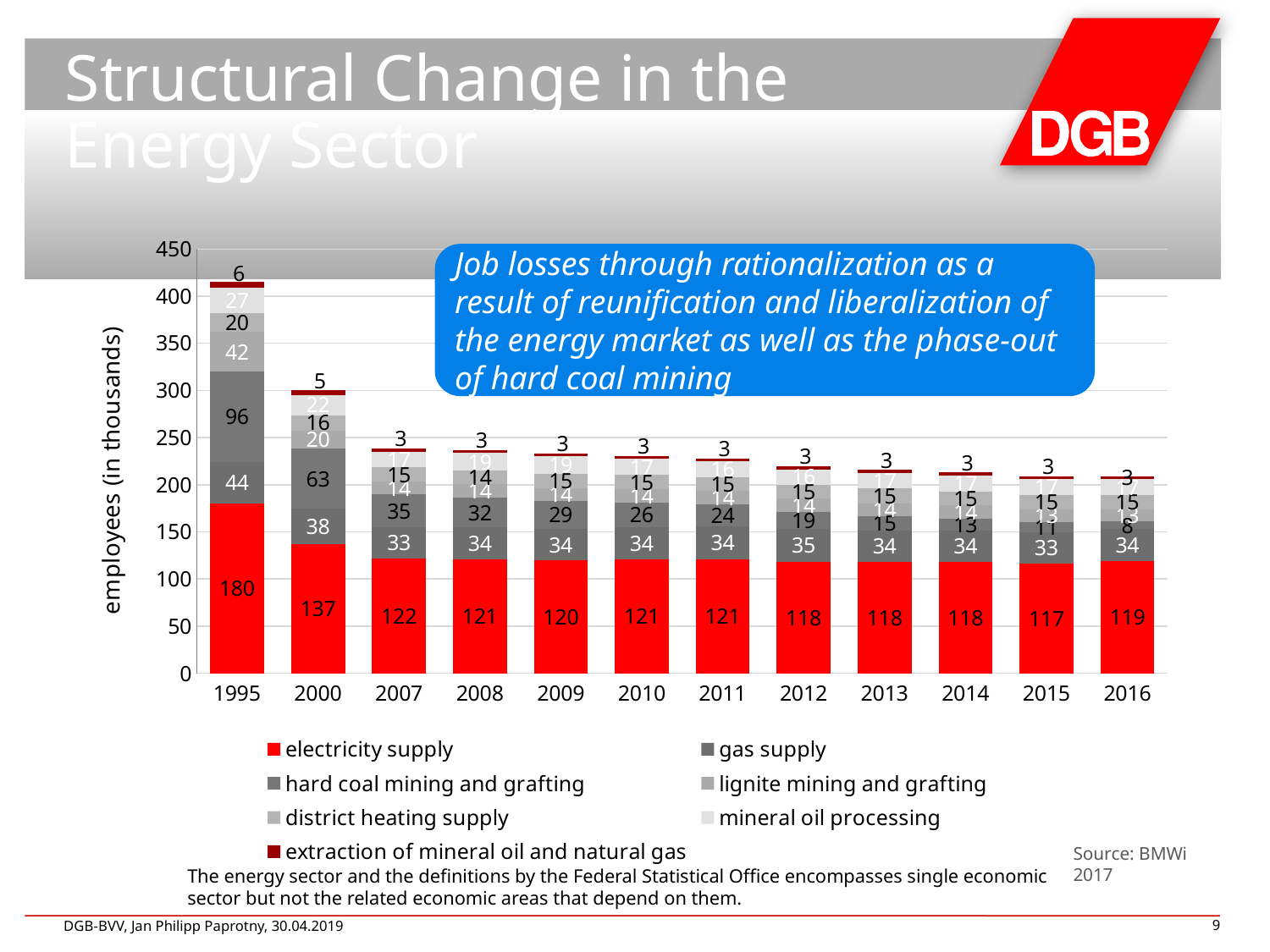
Does the hard coal mining and grafting value rise or fall from 2007 to 2016? fall What type of chart is shown on the slide? stacked bar chart What is the value for electricity supply in 1995? 180 What is the value for electricity supply in 2016? 119 In which year is the electricity supply value highest? 1995 How many years are shown on the x axis? 12 What is the value for extraction of mineral oil and natural gas in 1995? 6 What is the value for hard coal mining and grafting in 2016? 8 What is the value for hard coal mining and grafting in 2000? 63 What is the difference between the electricity supply values for 1995 and 2000? 43 Which is larger, the gas supply value in 1995 or in 2016? 1995 How many series does the legend list? 7